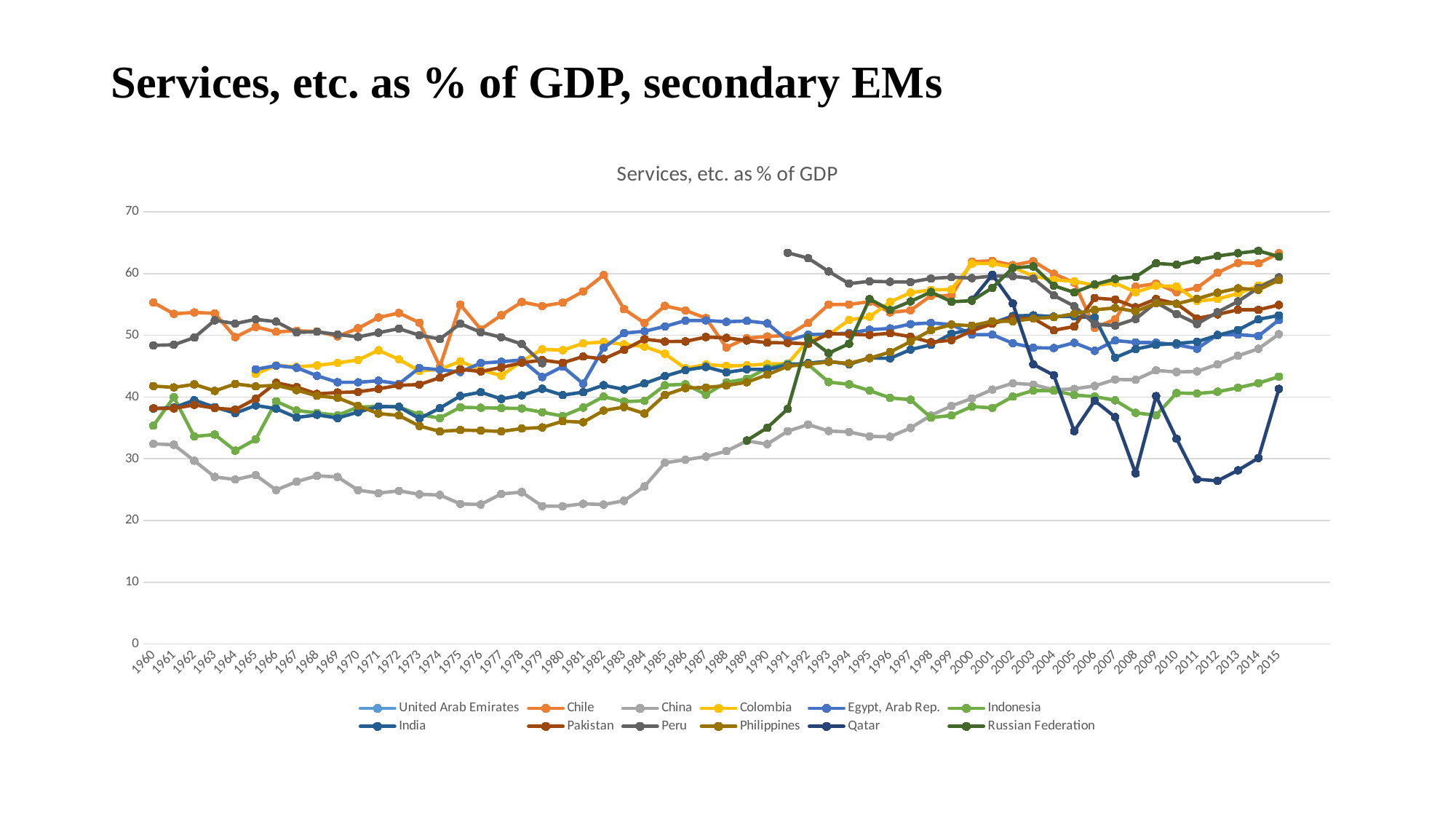
What kind of chart is shown on the slide? line chart Which series has the highest value in 1960? Chile How many years are plotted along the x axis? 56 Is the value for Qatar in 2011 greater or less than 30? less Is the value for Russian Federation in 2015 greater or less than 60? greater Is the value for Chile in 1960 greater or less than 50? greater How many series does the legend list? 12 In 2015, which is larger: the value for Qatar or the value for Russian Federation? Russian Federation What is the title shown above the plot area? Services, etc. as % of GDP Does the value for China rise or fall overall from 1960 to 2015? rise